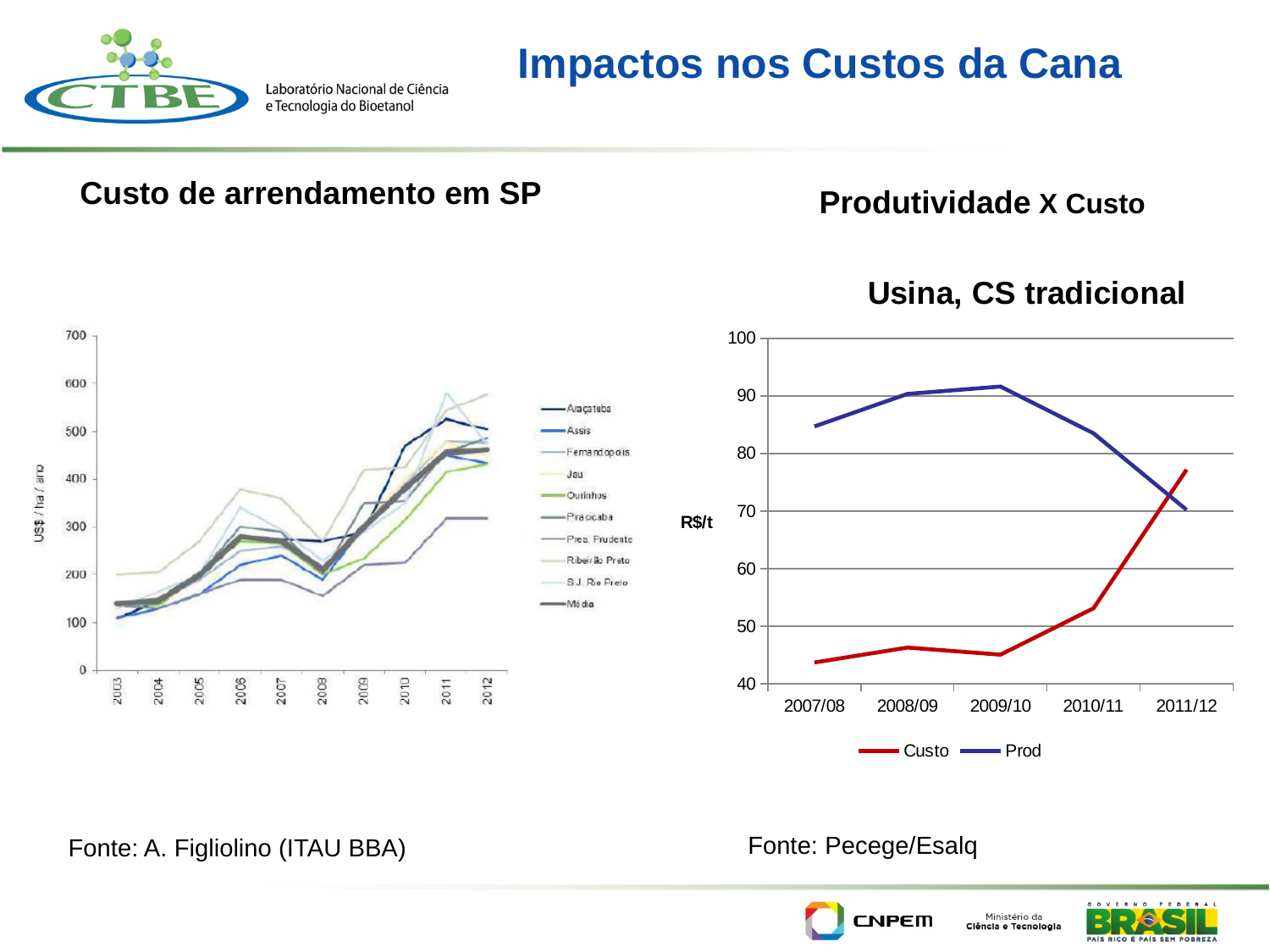
What is the y-axis label of the 'Custo de arrendamento em SP' chart? US$ / ha / ano In the 'Usina, CS tradicional' chart, in which season is Custo highest? 2011/12 How many seasons are shown on the x axis of the 'Usina, CS tradicional' chart? 5 In the 'Usina, CS tradicional' chart, which series has the higher value in 2011/12, Custo or Prod? Custo How many series does the legend of the 'Custo de arrendamento em SP' chart list? 10 How many series does the legend of the 'Usina, CS tradicional' chart list? 2 What kind of chart is the 'Usina, CS tradicional' chart on the right? line chart In the 'Usina, CS tradicional' chart, which series has the higher value in 2007/08, Custo or Prod? Prod In the 'Usina, CS tradicional' chart, does the Custo series rise or fall from 2007/08 to 2011/12? rise In the 'Usina, CS tradicional' chart, is the Custo value for 2007/08 greater or less than 50? less In the 'Usina, CS tradicional' chart, is the Custo value for 2011/12 greater or less than 70? greater In the 'Usina, CS tradicional' chart, is the Prod value for 2009/10 greater or less than 90? greater